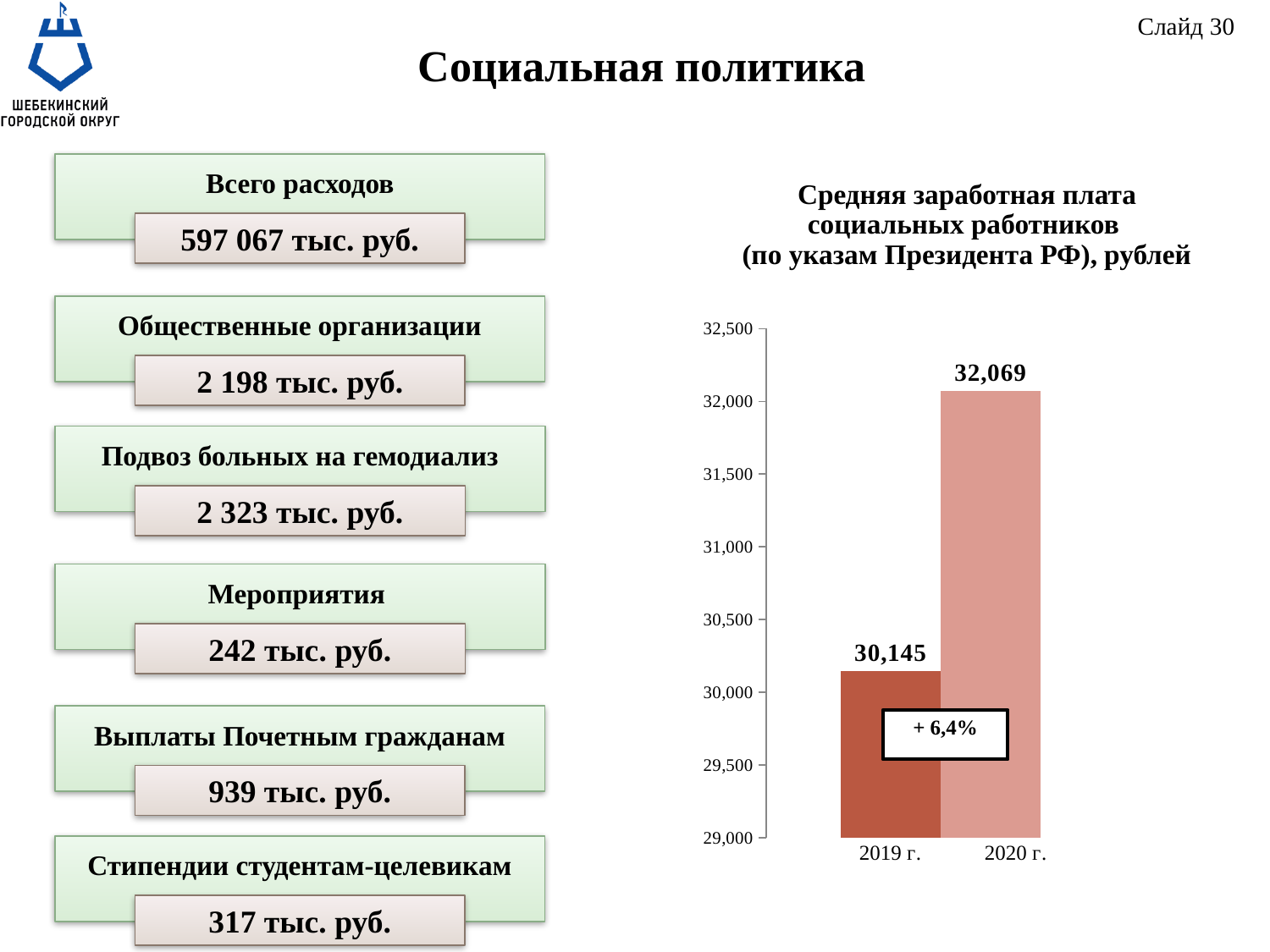
Is the value for 2019 г. larger or smaller than the value for 2020 г.? smaller Is the value for 2019 г. greater or less than 30,500? less Which year has the higher average salary of social workers on the chart? 2020 г. What percentage change is annotated on the chart between the two bars? + 6,4% What type of chart is used to show the average salary of social workers? bar chart How many bars are plotted on the chart? 2 By how much does the 2020 г. value exceed the 2019 г. value on the chart? 1,924 What is the average salary of social workers shown for 2020 г.? 32,069 What is the average salary of social workers shown for 2019 г.? 30,145 Which year has the lower average salary of social workers on the chart? 2019 г. Does the average salary rise or fall from 2019 г. to 2020 г.? rise Is the value for 2020 г. greater or less than 32,000? greater